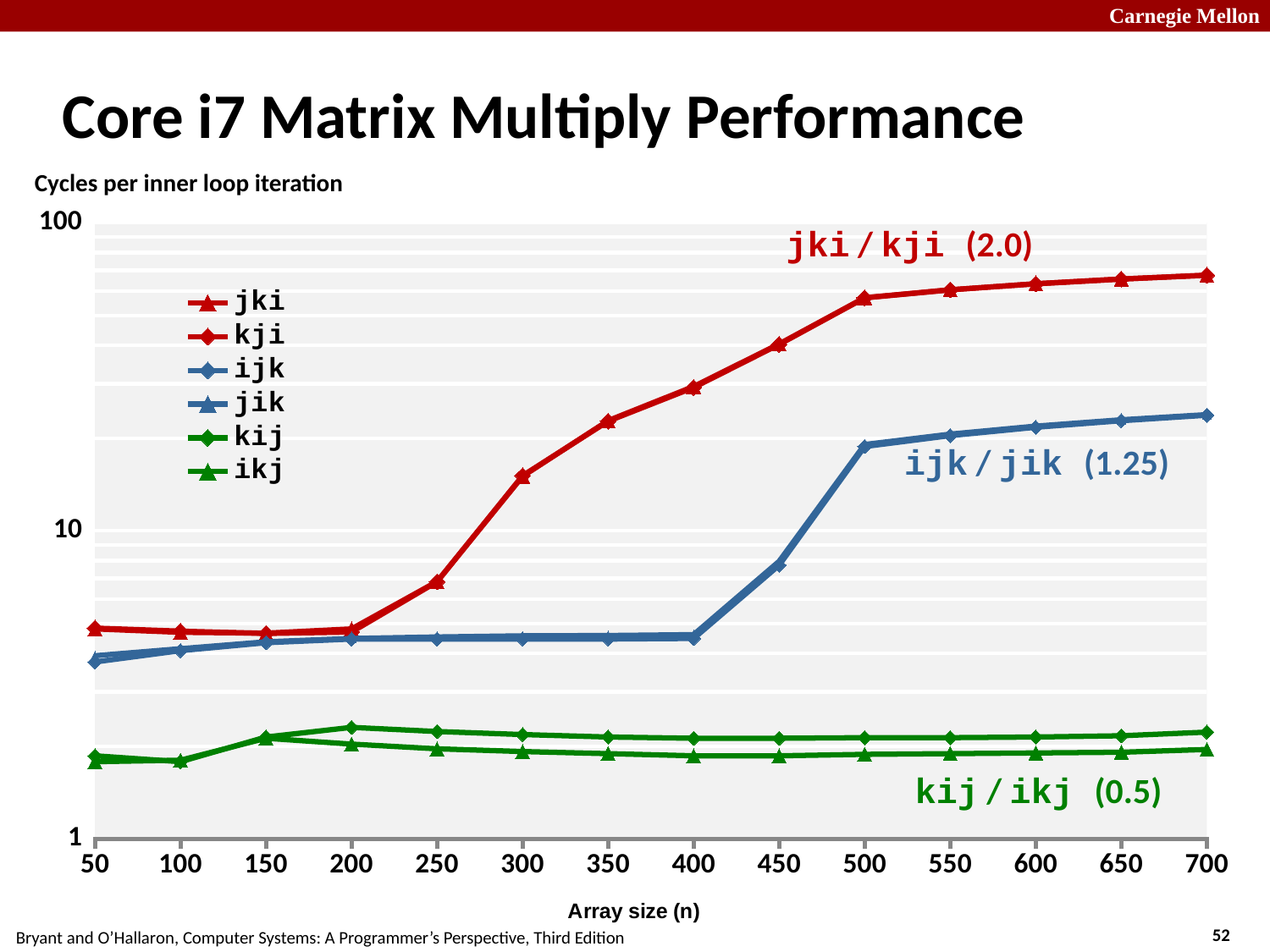
At array size 700, which is larger, the value for jki or the value for ikj? jki Is the value for ijk at array size 400 greater or less than 10? less What quantity does the y axis of the chart measure, according to the label above it? Cycles per inner loop iteration Is the value for kij at array size 700 greater or less than 10? less Do the values for jki rise or fall as the array size increases from 200 to 700? rise Is the value for jki at array size 300 greater or less than 10? greater How many series does the legend list? 6 What kind of chart is shown on the slide? line chart What is the label on the x axis of the chart? Array size (n) How many array size values are marked along the x axis? 14